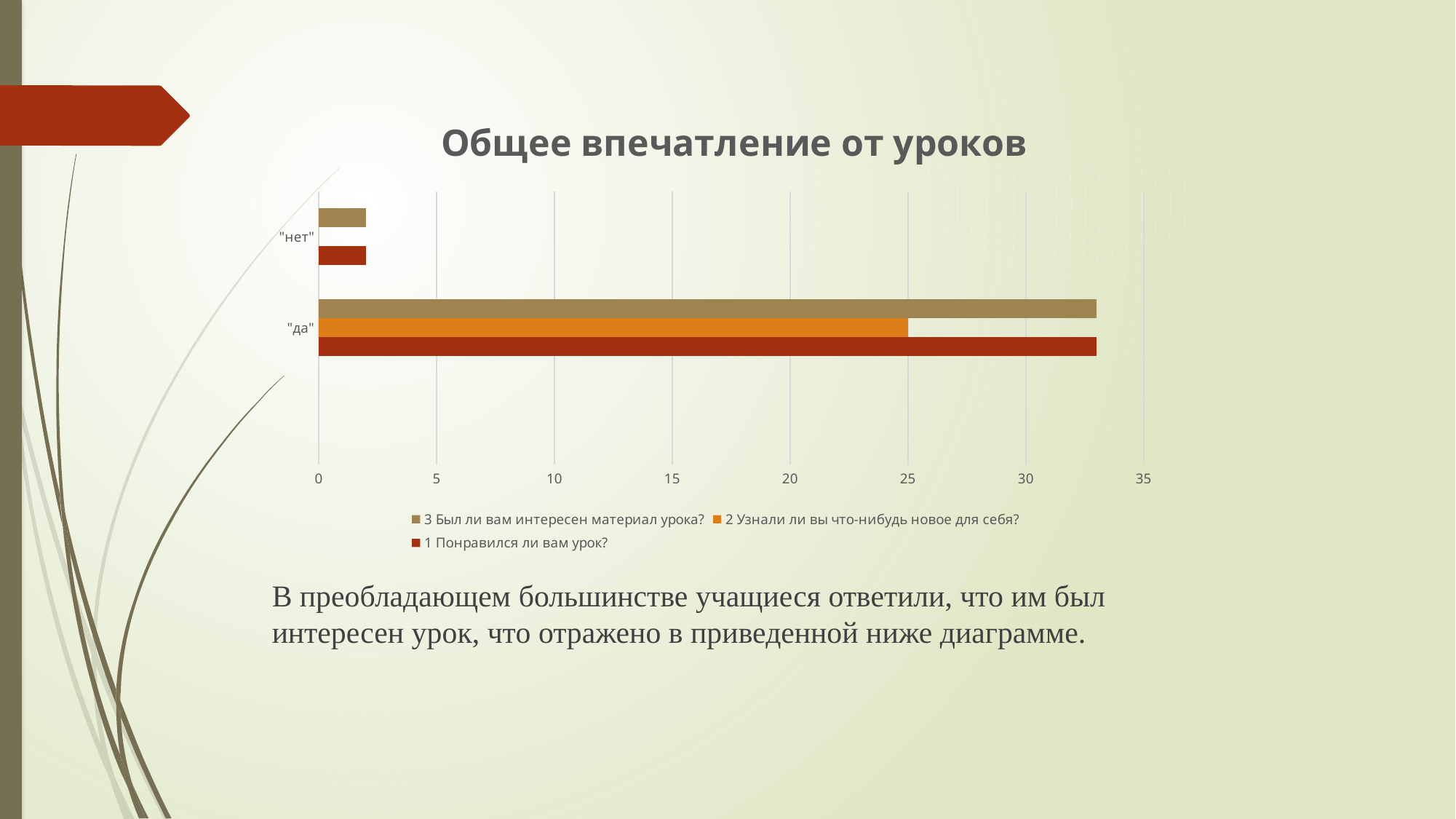
Is the value for "нет" in the series "1 Понравился ли вам урок?" greater or less than 5? less How many series does the chart legend list? 3 Which category has the higher values, "да" or "нет"? "да" Which series has the lowest value for the category "да"? 2 Узнали ли вы что-нибудь новое для себя? How many categories are shown on the vertical axis of the chart? 2 What is the highest value shown on the horizontal axis of the chart? 35 For the category "да", which is larger: the value for "3 Был ли вам интересен материал урока?" or the value for "2 Узнали ли вы что-нибудь новое для себя?"? 3 Был ли вам интересен материал урока? What is the value for "да" in the series "2 Узнали ли вы что-нибудь новое для себя?"? 25 Is the value for "да" in the series "1 Понравился ли вам урок?" greater or less than 30? greater What kind of chart is shown on the slide? bar chart What is the title of the chart? Общее впечатление от уроков Is the value for "да" in the series "3 Был ли вам интересен материал урока?" greater or less than 30? greater